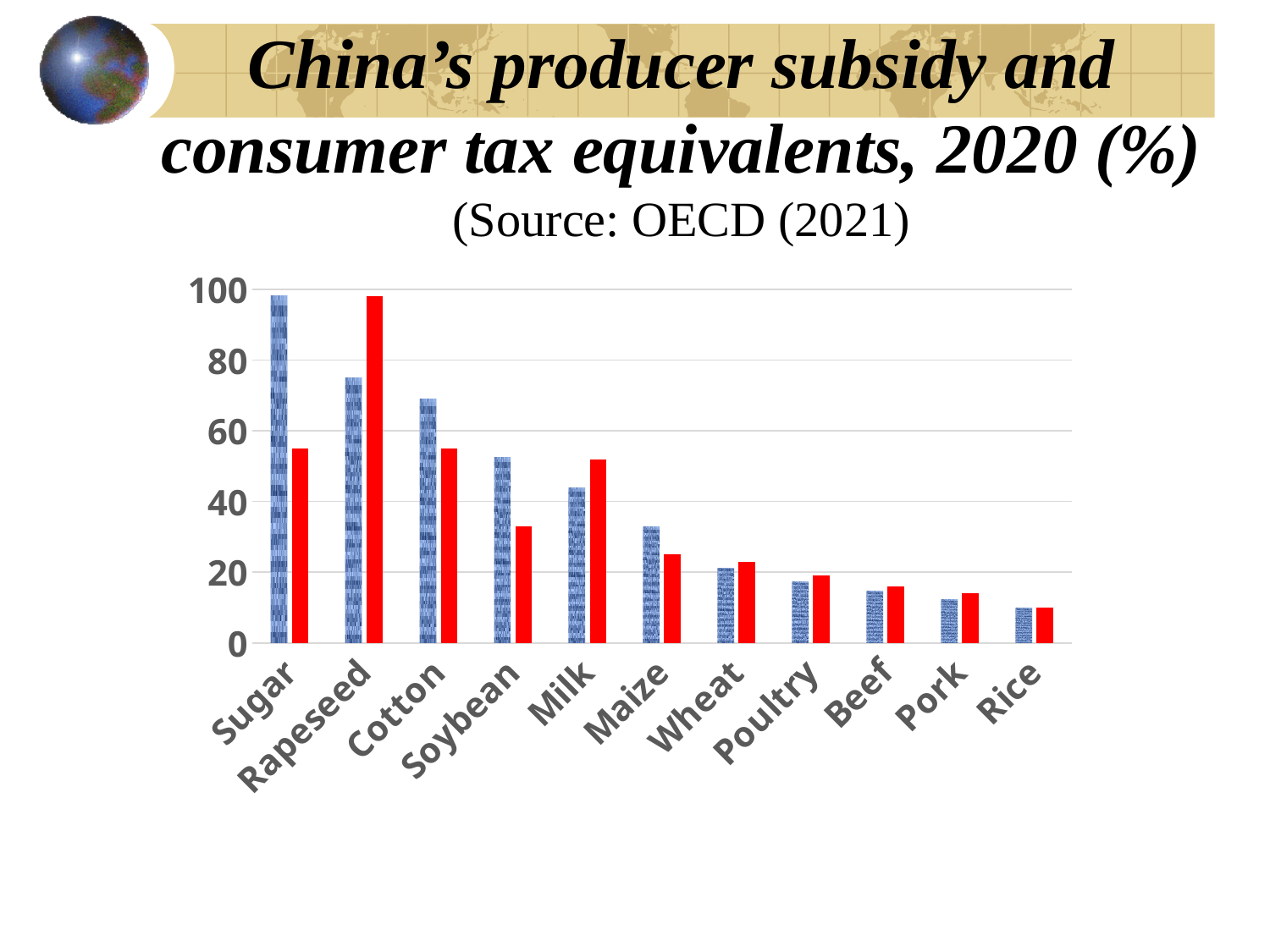
For Rapeseed, which bar is taller, the blue one or the red one? the red one Is the blue bar for Cotton greater or less than 60? greater Is the blue bar for Sugar greater or less than 80? greater Do the blue bars generally rise or fall from Sugar on the left to Rice on the right? fall Is the red bar for Milk greater or less than 40? greater Which commodity has the tallest blue bar? Sugar Which commodity has the shortest red bar? Rice Which commodity has the tallest red bar? Rapeseed For Soybean, which bar is taller, the blue one or the red one? the blue one What kind of chart is shown on the slide? bar chart How many commodity categories are shown on the x axis? 11